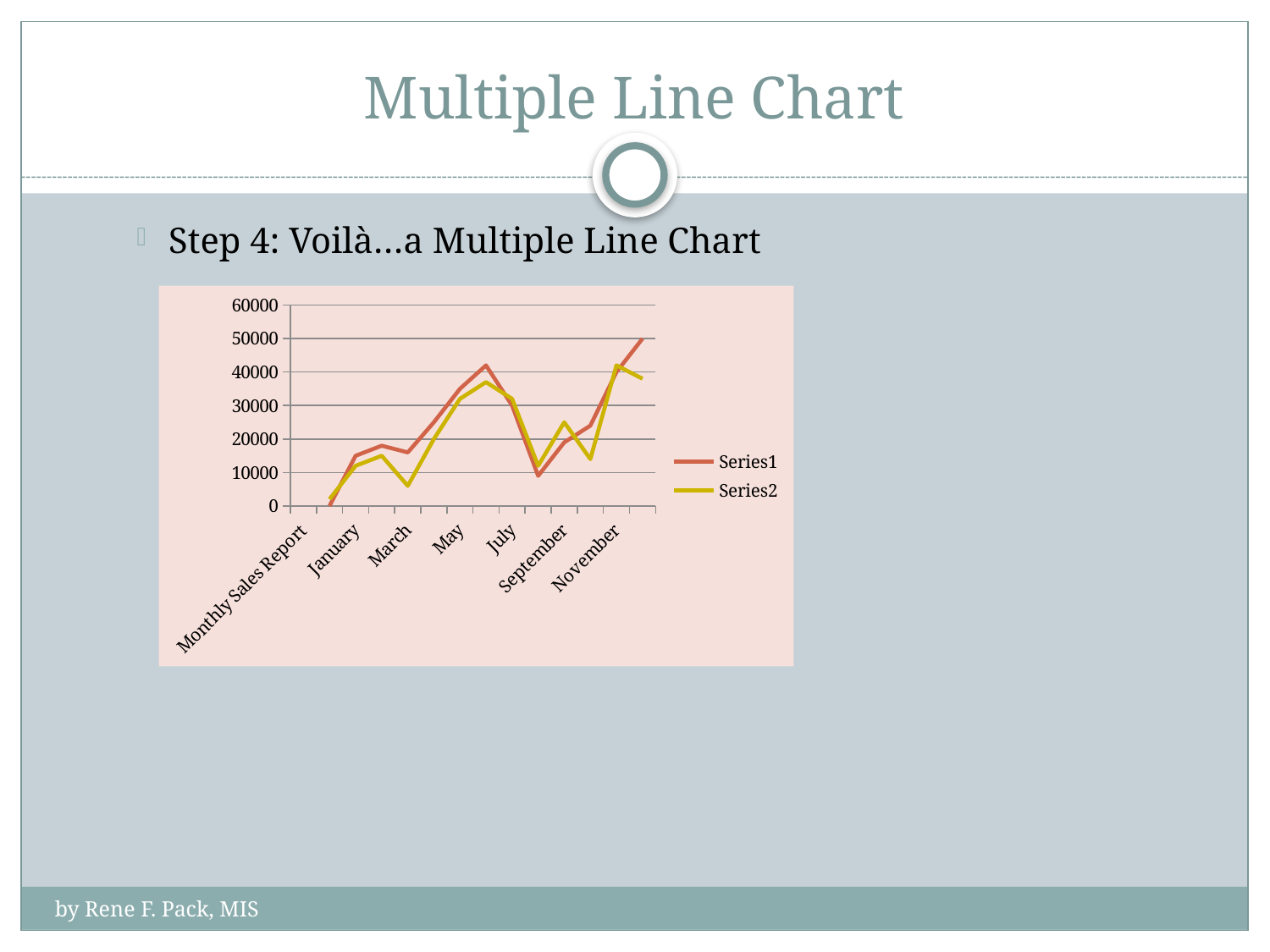
Is the value for Series2 in March greater or less than 10000? less In which month does Series1 reach its highest value? December What are the names of the two series in the legend? Series1 and Series2 In September, which series has the larger value, Series1 or Series2? Series2 What colour is the line for Series2? yellow Is the value for Series1 in March greater or less than 10000? greater How many series does the chart's legend list? 2 What kind of chart is shown on the slide? line chart Among the months January to December, in which month is Series2 at its lowest? March Is the value for Series1 in May greater or less than 30000? greater In March, which series has the larger value, Series1 or Series2? Series1